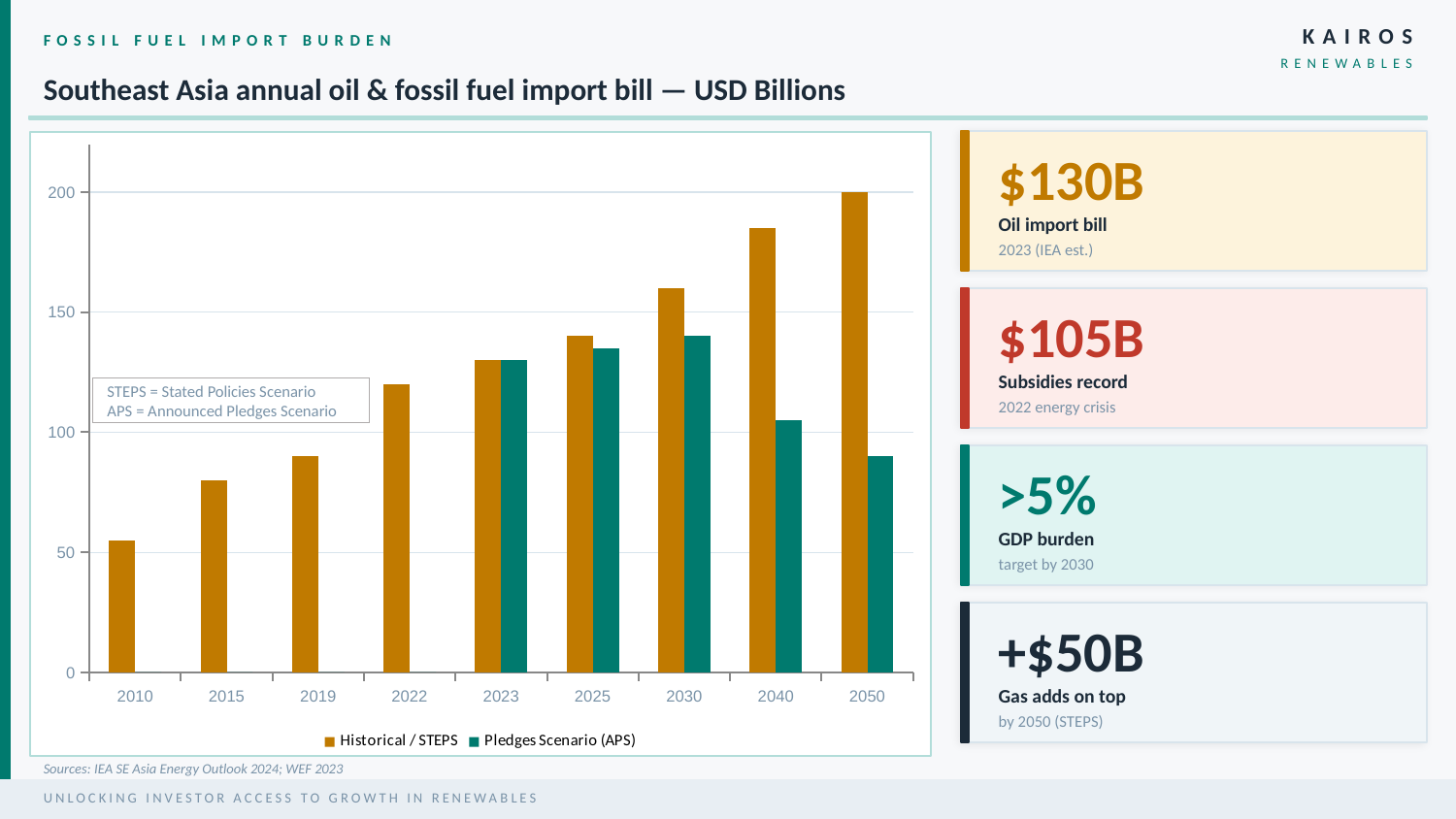
What are the two series names listed in the chart legend? Historical / STEPS; Pledges Scenario (APS) Is the Pledges Scenario (APS) value for 2050 greater or less than 100? less Which year has the highest Historical / STEPS value? 2050 Is the Historical / STEPS value for 2030 greater or less than 150? greater How many series does the chart legend list? 2 Do the Historical / STEPS values rise or fall from 2010 to 2050? rise How many year categories are shown on the x axis of the chart? 9 Is the Historical / STEPS value for 2015 greater or less than 100? less In 2040, which is larger: the Historical / STEPS value or the Pledges Scenario (APS) value? Historical / STEPS What kind of chart is shown on the slide? bar chart Which year has the lowest Historical / STEPS value? 2010